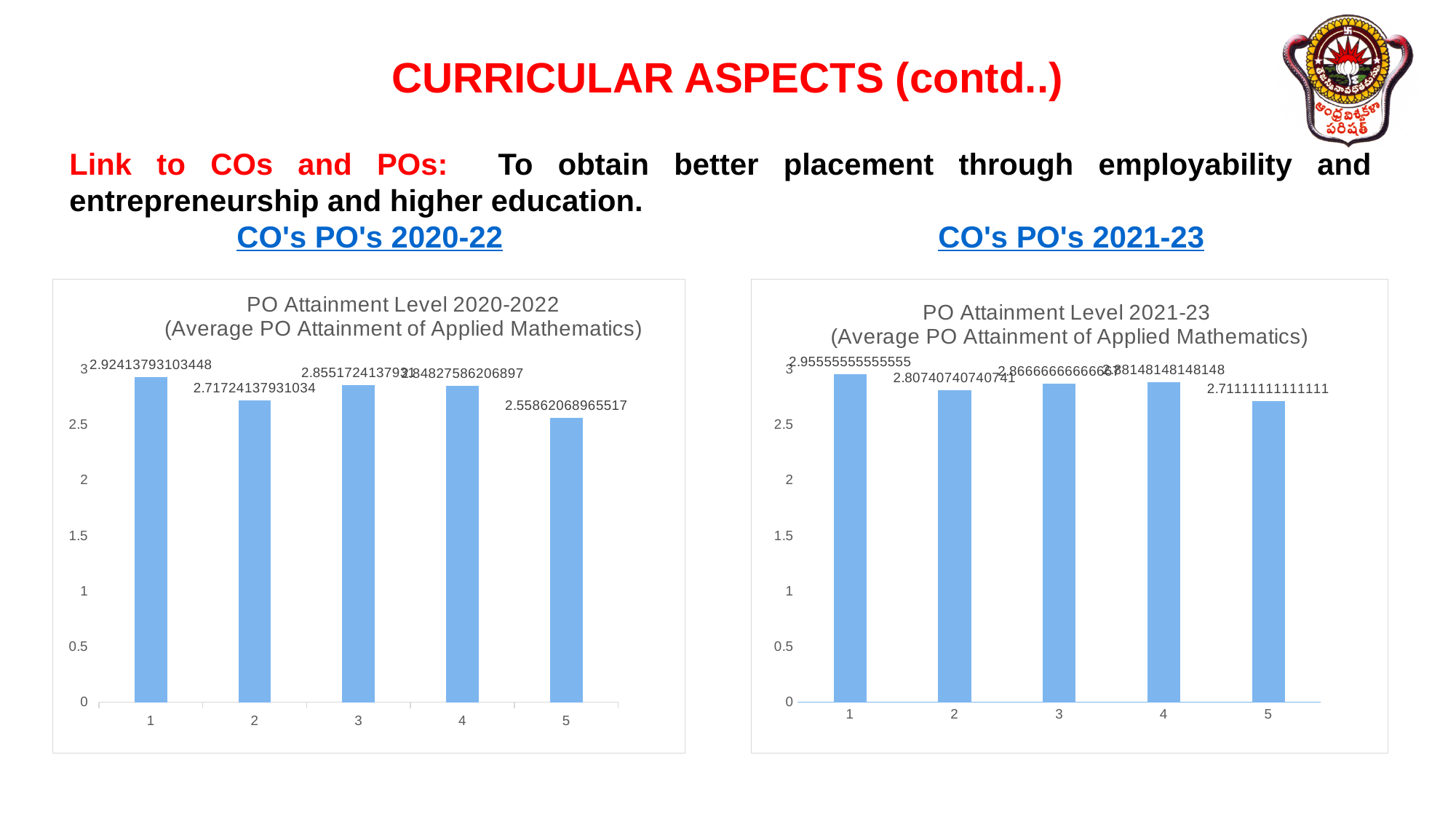
In the right chart (PO Attainment Level 2021-23), what is the value for category 5? 2.71111111111111 In the left chart (PO Attainment Level 2020-2022), what is the difference between the values for category 1 and category 5? 0.36551724137931 In the left chart (PO Attainment Level 2020-2022), what is the value for category 1? 2.92413793103448 In the right chart (PO Attainment Level 2021-23), which is larger, the value for category 1 or category 2? Category 1 What kind of chart is the left chart (PO Attainment Level 2020-2022)? Bar chart In the left chart (PO Attainment Level 2020-2022), what is the value for category 5? 2.55862068965517 In the left chart (PO Attainment Level 2020-2022), is the value for category 5 greater or less than 2.5? greater In the right chart (PO Attainment Level 2021-23), what is the value for category 1? 2.95555555555555 How many categories are plotted in the right chart (PO Attainment Level 2021-23)? 5 In the left chart (PO Attainment Level 2020-2022), which category has the highest value? 1 In the right chart (PO Attainment Level 2021-23), which category has the lowest value? 5 In the left chart (PO Attainment Level 2020-2022), what is the value for category 2? 2.71724137931034